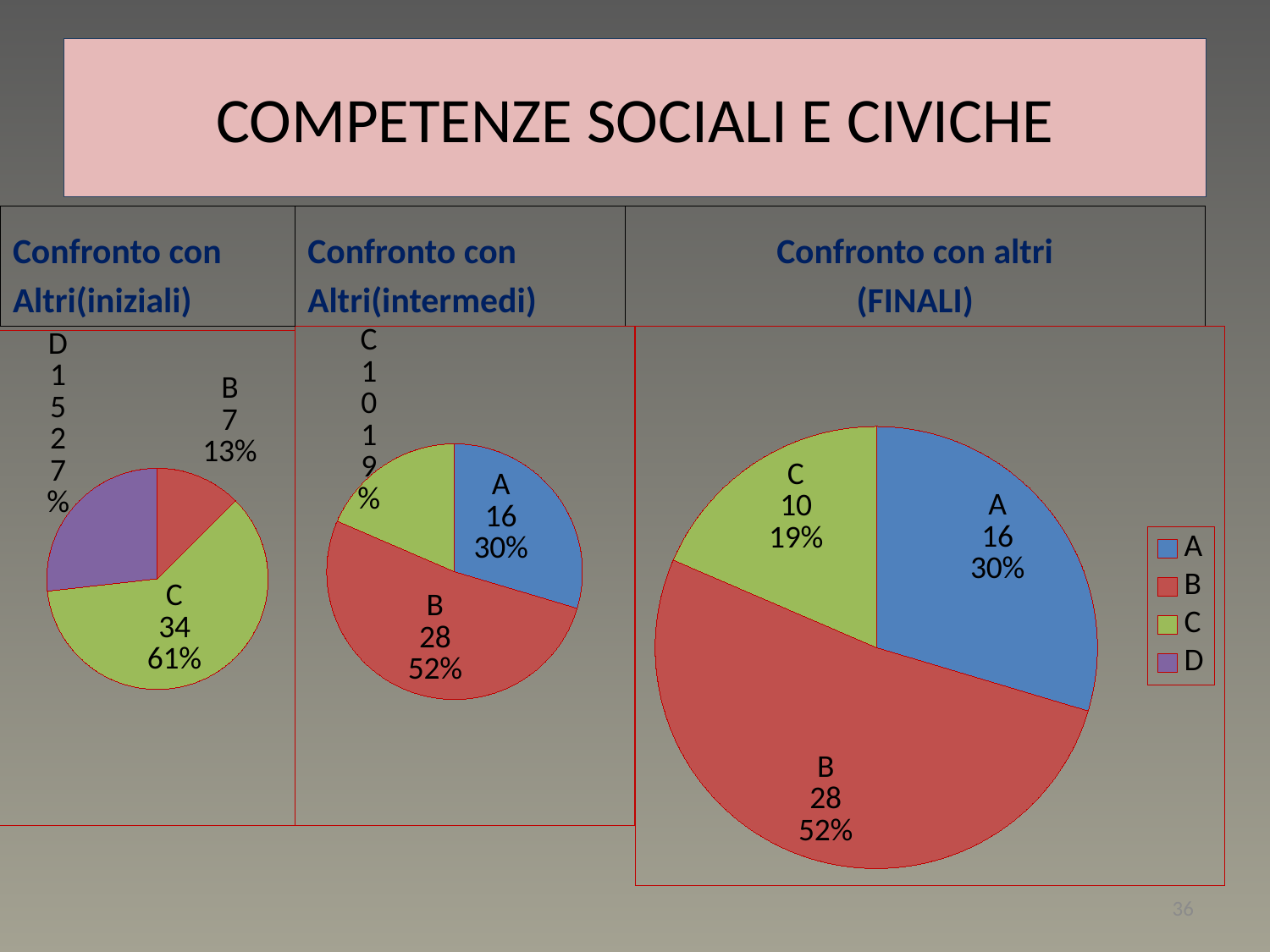
How many entries does the legend on the slide list? 4 In the 'Confronto con altri (FINALI)' chart, which category has the smallest slice? C In the 'Confronto con altri (FINALI)' chart, what share of the pie does slice A represent? 30% In the 'Confronto con Altri(intermedi)' chart, which is larger, the value for A or the value for B? B In the 'Confronto con altri (FINALI)' chart, what is the difference between the values for B and A? 12 In the 'Confronto con altri (FINALI)' chart, which category has the largest slice? B In the 'Confronto con Altri(iniziali)' chart, what share of the pie does slice C represent? 61% In the 'Confronto con altri (FINALI)' chart, what is the value for B? 28 In the 'Confronto con Altri(iniziali)' chart, what is the value for B? 7 In the 'Confronto con Altri(intermedi)' chart, what is the value for C? 10 In the 'Confronto con altri (FINALI)' chart, what share of the pie does slice C represent? 19% What kind of chart is the 'Confronto con altri (FINALI)' chart? Pie chart